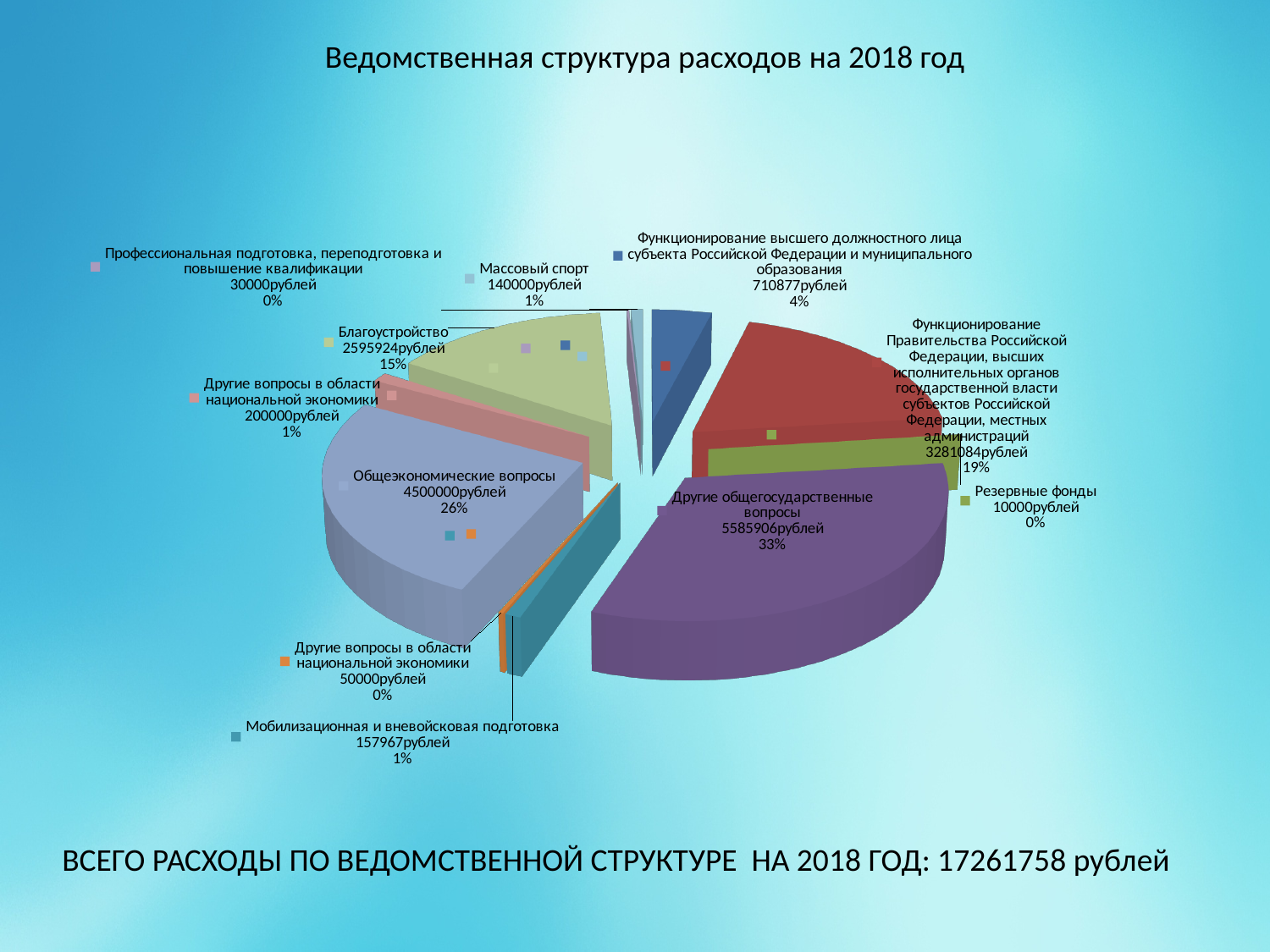
What is the title of the chart? Ведомственная структура расходов на 2018 год Which category has the largest share of the pie? Другие общегосударственные вопросы What is the value for Благоустройство? 2595924рублей Which category has the smallest value in the pie chart? Резервные фонды What is the value for Общеэкономические вопросы? 4500000рублей What is the difference between the values for Другие общегосударственные вопросы and Общеэкономические вопросы? 1085906 рублей What share of the pie does Функционирование Правительства Российской Федерации, высших исполнительных органов государственной власти субъектов Российской Федерации, местных администраций represent? 19% What is the value for Массовый спорт? 140000рублей What kind of chart is shown on the slide? pie chart Which is larger: the value for Благоустройство or the value for Функционирование высшего должностного лица субъекта Российской Федерации и муниципального образования? Благоустройство How many categories (slices) does the pie chart have? 11 What share of the pie does Другие общегосударственные вопросы represent? 33%